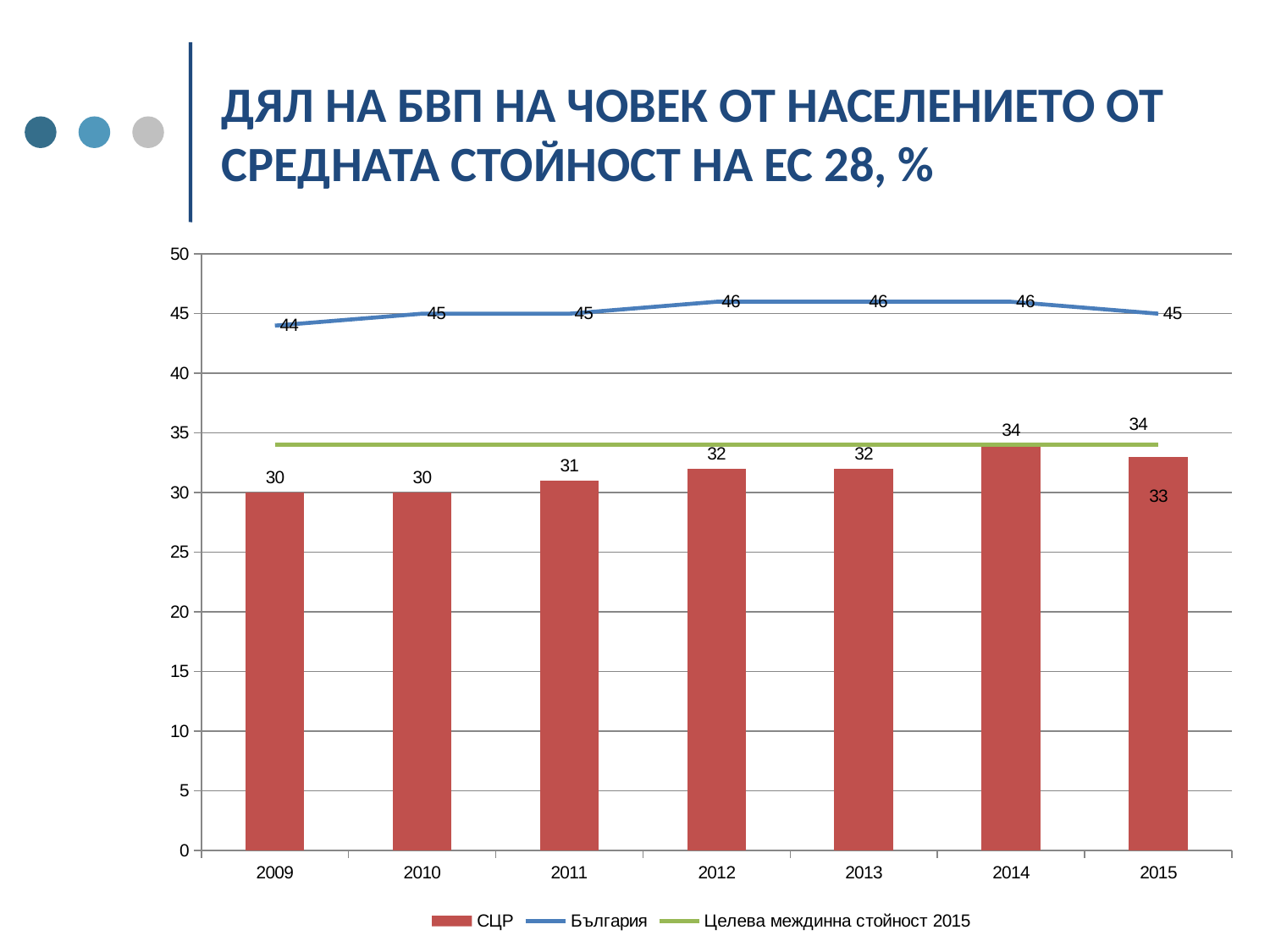
What is the value for СЦР in 2015? 33 In which year is the СЦР bar highest? 2014 Is the value for СЦР in 2009 greater or less than 35? less Which is larger in 2012: the value for България or the value for СЦР? България What is the difference between the България value and the СЦР value in 2014? 12 What kind of chart is used for the СЦР series? bar chart How many years are shown on the x axis? 7 How many series does the legend list? 3 What is the lowest value shown for the България line? 44 What is the value for СЦР in 2011? 31 What is the value for България in 2009? 44